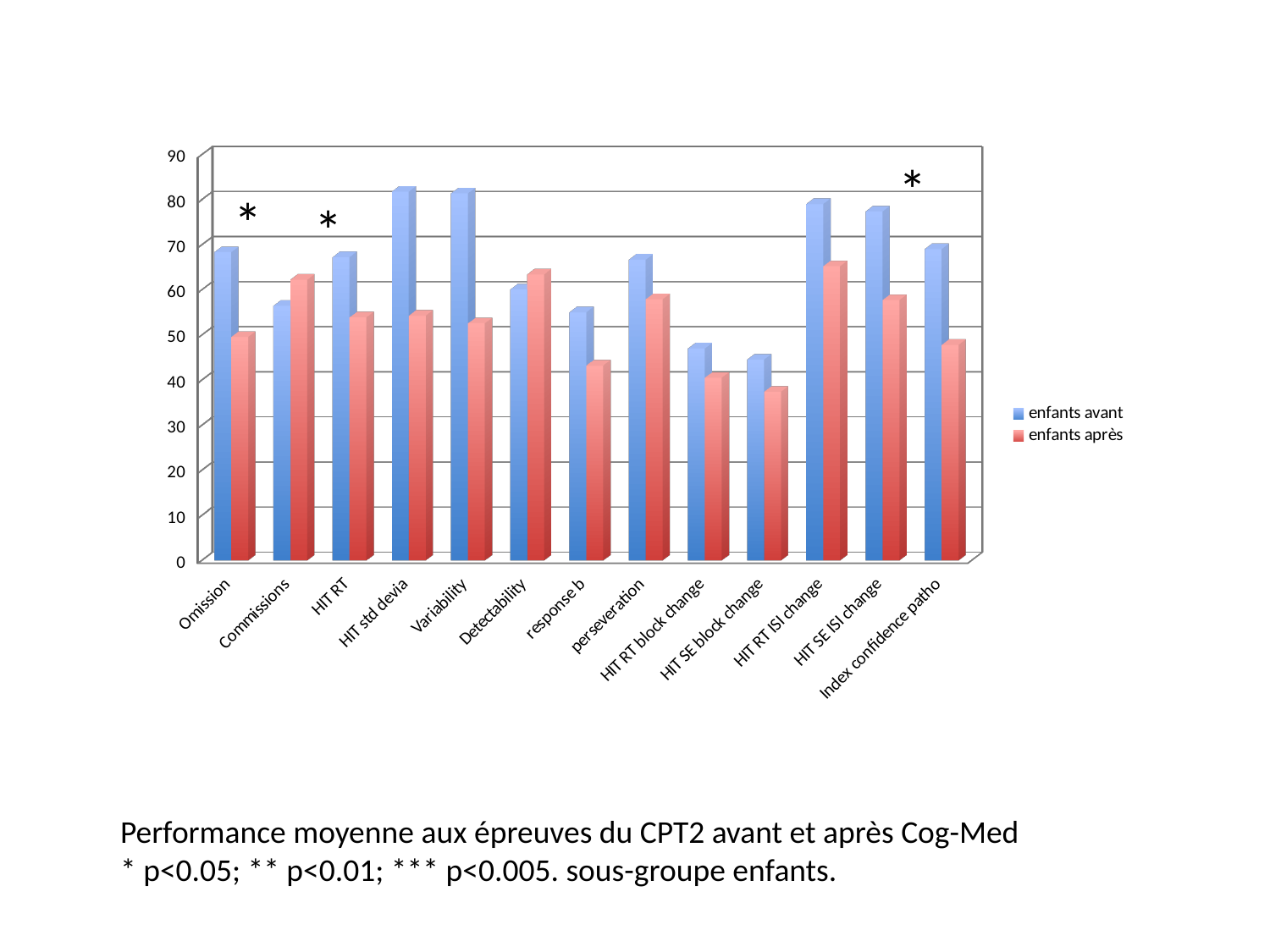
Is the 'enfants avant' value for Omission greater or less than 60? greater Is the 'enfants après' value for Omission greater or less than 60? less Is the 'enfants après' value for HIT SE block change greater or less than 50? less What kind of chart is shown on the slide? bar chart For Commissions, which series has the larger value, 'enfants avant' or 'enfants après'? enfants après What are the two series named in the legend? enfants avant, enfants après How many categories are shown on the x axis? 13 For Variability, which series has the larger value, 'enfants avant' or 'enfants après'? enfants avant Which colour represents the 'enfants après' series? red How many series does the legend list? 2